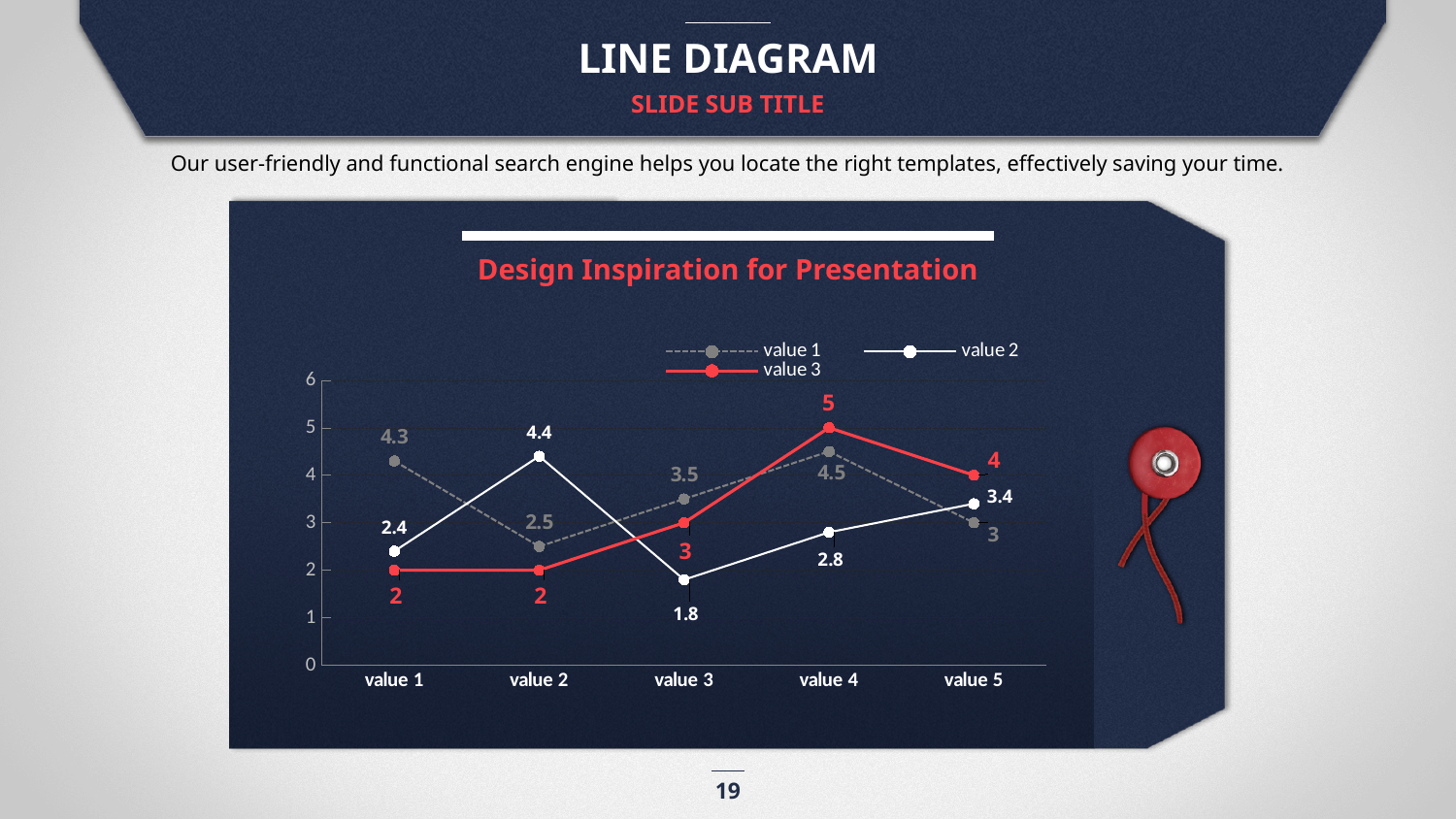
What is the value of the 'value 1' series at category 'value 4'? 4.5 At which category does the 'value 2' series have its lowest value? value 3 How many series does the legend list? 3 What is the difference between the 'value 1' and 'value 2' series at category 'value 1'? 1.9 What is the title of the chart? Design Inspiration for Presentation Does the 'value 3' series rise or fall from category 'value 4' to 'value 5'? fall How many categories are shown on the x axis? 5 At category 'value 2', which series is larger: 'value 1' or 'value 2'? value 2 What is the value of the 'value 3' series at category 'value 5'? 4 What kind of chart is shown on the slide? line chart At which category does the 'value 3' series reach its highest value? value 4 What is the value of the 'value 2' series at category 'value 3'? 1.8